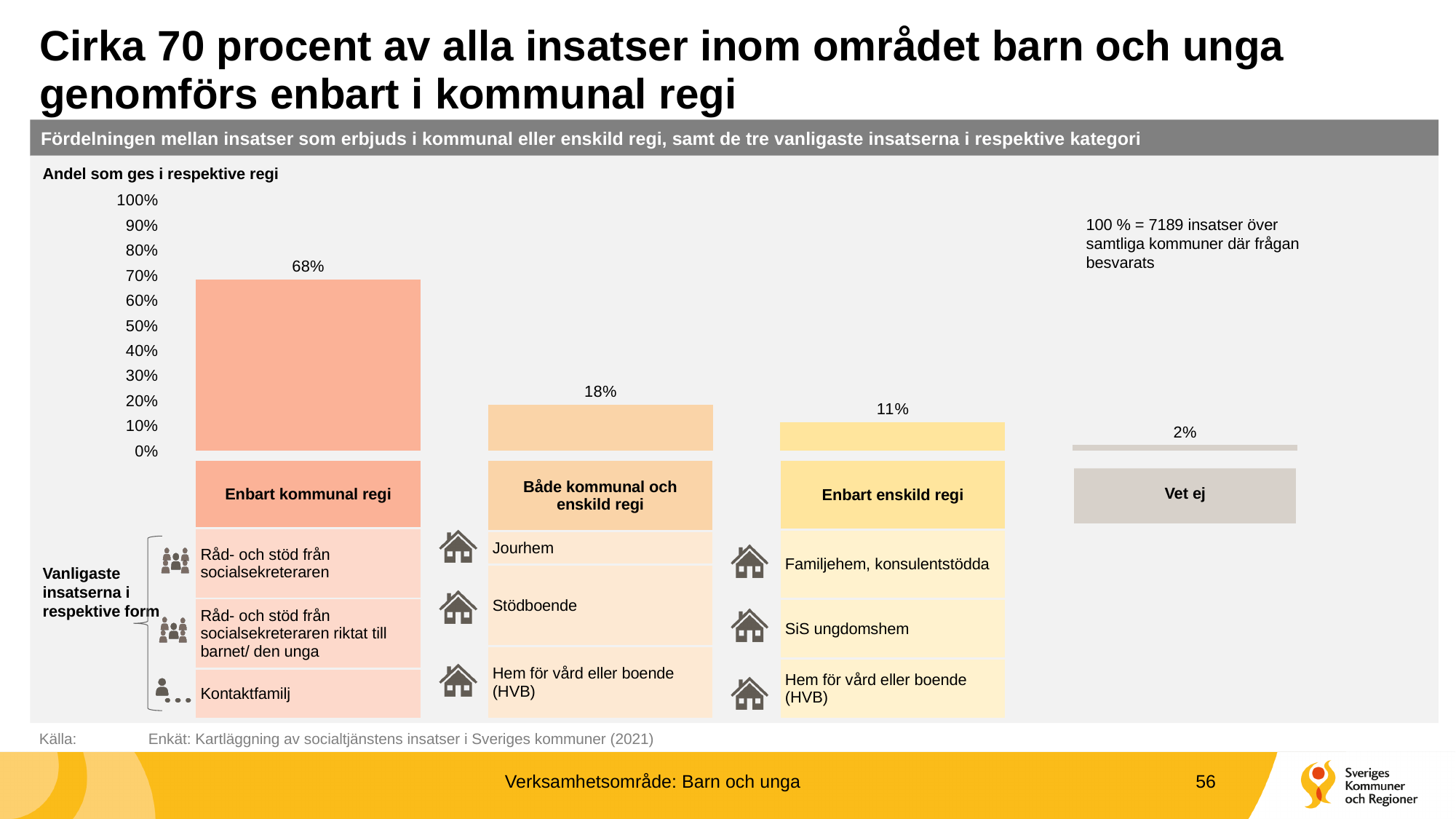
What share of insatser is given in 'Både kommunal och enskild regi'? 18% What type of chart is shown on the slide? Bar chart What is the difference in percentage points between 'Enbart kommunal regi' and 'Både kommunal och enskild regi'? 50 percentage points How many insatser does 100% correspond to according to the note on the chart? 7189 Which category has the highest share? Enbart kommunal regi Which category has the lowest share? Vet ej Which is larger: the share for 'Enbart enskild regi' or for 'Vet ej'? Enbart enskild regi How many categories are shown in the bar chart? 4 What share of insatser is given in 'Enbart kommunal regi'? 68% What share of insatser is given in 'Enbart enskild regi'? 11% What share of insatser falls under 'Vet ej'? 2% What is the difference in percentage points between 'Både kommunal och enskild regi' and 'Enbart enskild regi'? 7 percentage points